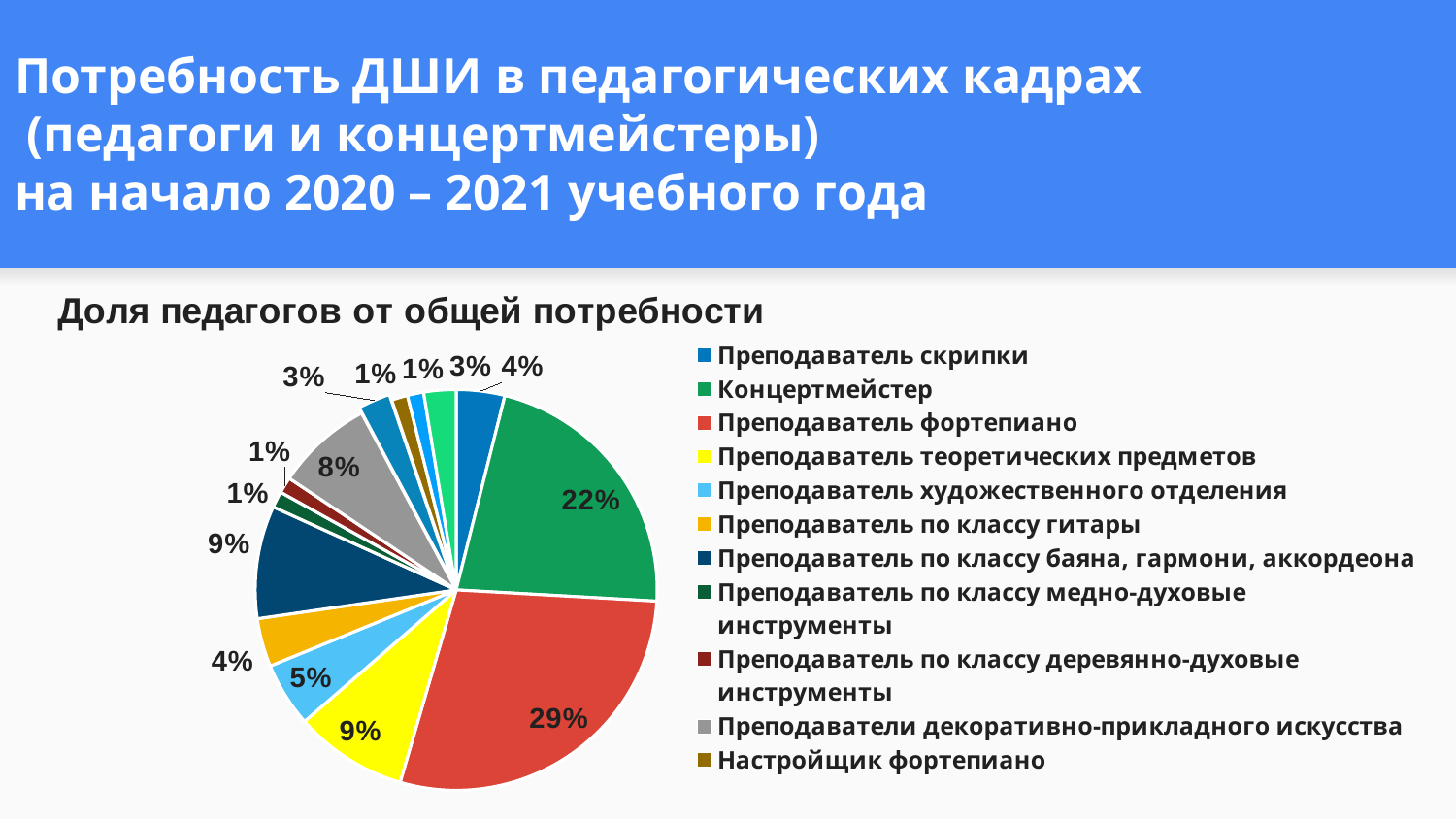
Which is larger: the share for Концертмейстер or the share for Преподаватель теоретических предметов? Концертмейстер What share of the total need is Концертмейстер? 22% What is the value for Преподаватель по классу гитары? 4% What share of the total need is Преподаватель фортепиано? 29% What is the difference in percentage points between Преподаватель фортепиано and Концертмейстер? 7 percentage points What is the title of the chart? Доля педагогов от общей потребности What is the value for Преподаватель художественного отделения? 5% What kind of chart is shown on the slide? pie chart What is the value for Преподаватель скрипки? 4% Which category has the largest share of the pie? Преподаватель фортепиано What is the value for Преподаватели декоративно-прикладного искусства? 8% What is the value for Преподаватель теоретических предметов? 9%